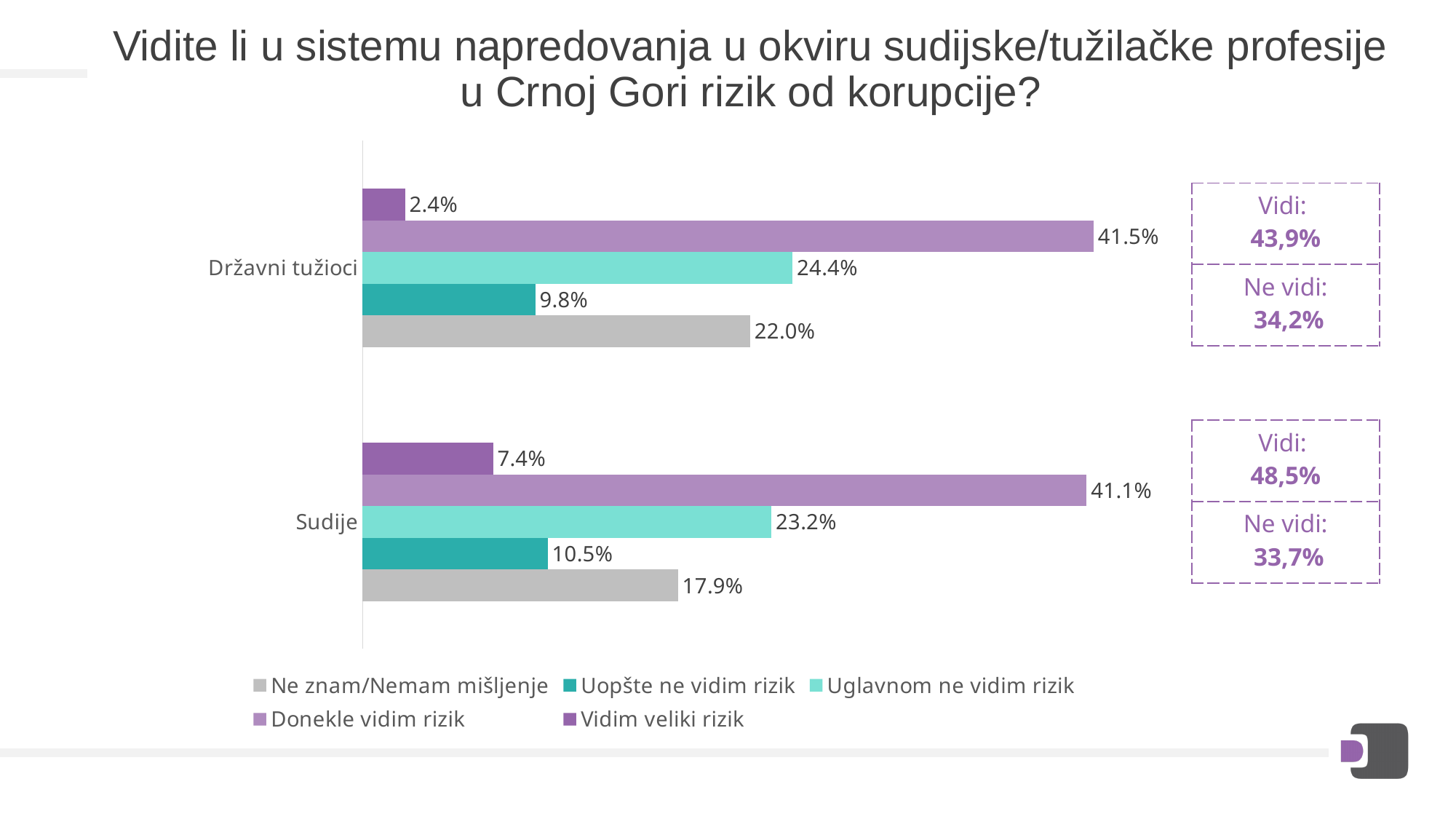
What is the value for "Uopšte ne vidim rizik" for Sudije? 10.5% What is the value for "Donekle vidim rizik" for Državni tužioci? 41.5% How many categories are shown on the vertical axis? 2 What is the difference between the "Uglavnom ne vidim rizik" values for Državni tužioci and Sudije? 1.2% Which is larger: "Ne znam/Nemam mišljenje" for Državni tužioci or for Sudije? Državni tužioci Which series has the highest value for Sudije? Donekle vidim rizik What is the value for "Vidim veliki rizik" for Sudije? 7.4% How many series does the legend list? 5 Which series has the lowest value for Državni tužioci? Vidim veliki rizik What colour are the "Ne znam/Nemam mišljenje" bars? Grey What is the value for "Ne znam/Nemam mišljenje" for Državni tužioci? 22.0% What kind of chart is shown on the slide? Bar chart